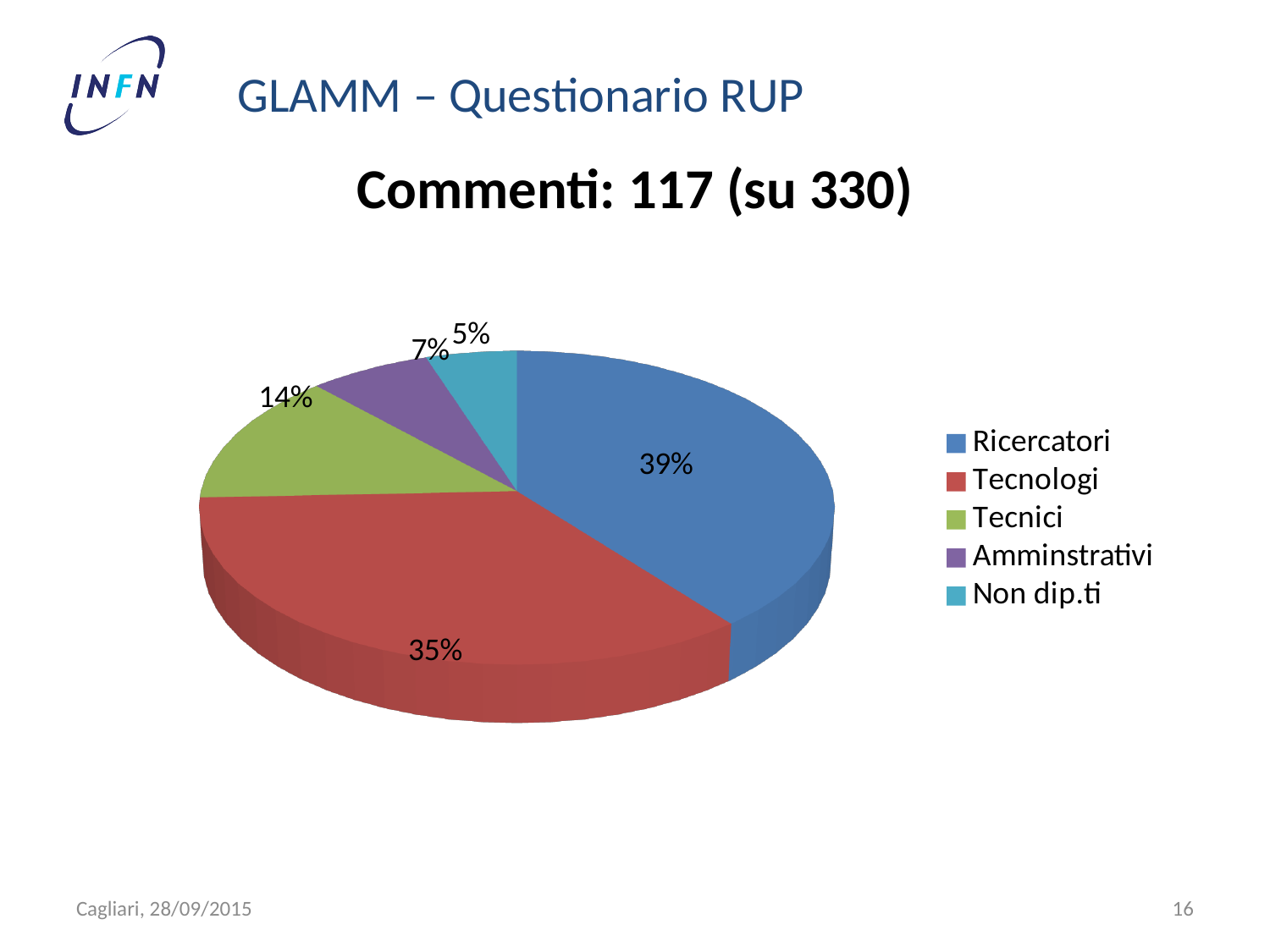
What share of the pie does Amminstrativi represent? 7% What is the difference in percentage points between the Ricercatori and Tecnologi slices? 4 What share of the pie does Ricercatori represent? 39% How many categories does the legend list? 5 What kind of chart is shown on the slide? Pie chart Which is larger, the Tecnici slice or the Amminstrativi slice? Tecnici What share of the pie does Tecnologi represent? 35% Which category has the largest slice of the pie? Ricercatori What is the title shown above the chart? Commenti: 117 (su 330) Which category has the smallest slice of the pie? Non dip.ti